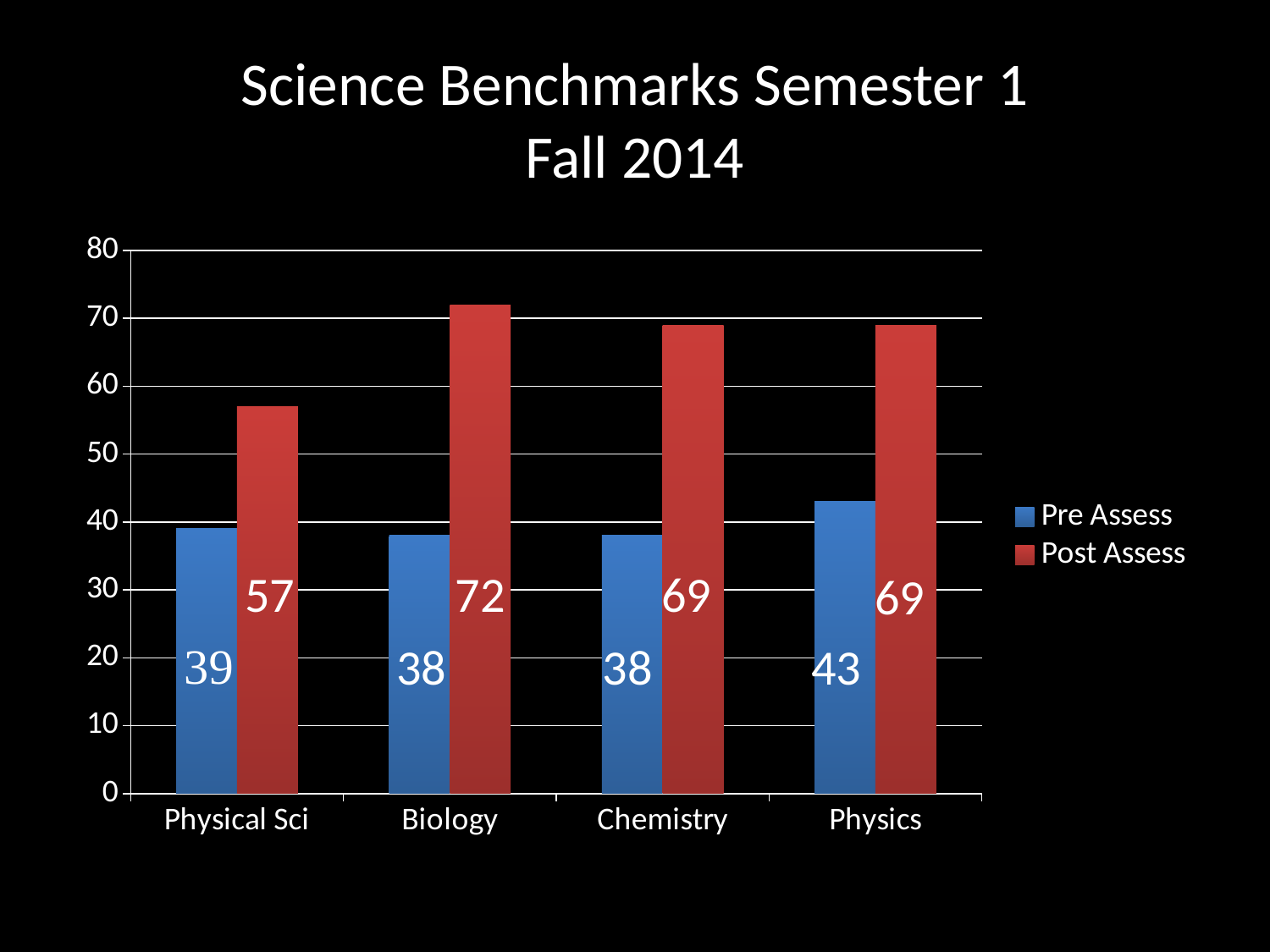
Which category has the highest Post Assess value? Biology What is the difference between the Post Assess and Pre Assess values for Biology? 34 How many categories are shown on the x axis? 4 What is the Post Assess value for Biology? 72 Which category has the lowest Post Assess value? Physical Sci How many series does the legend list? 2 Which category has the highest Pre Assess value? Physics What is the Post Assess value for Physical Sci? 57 Is the Pre Assess value for Physical Sci greater or less than 50? less Which is larger, the Post Assess value for Physical Sci or the Post Assess value for Chemistry? Chemistry What kind of chart is shown on the slide? bar chart What is the Pre Assess value for Physics? 43